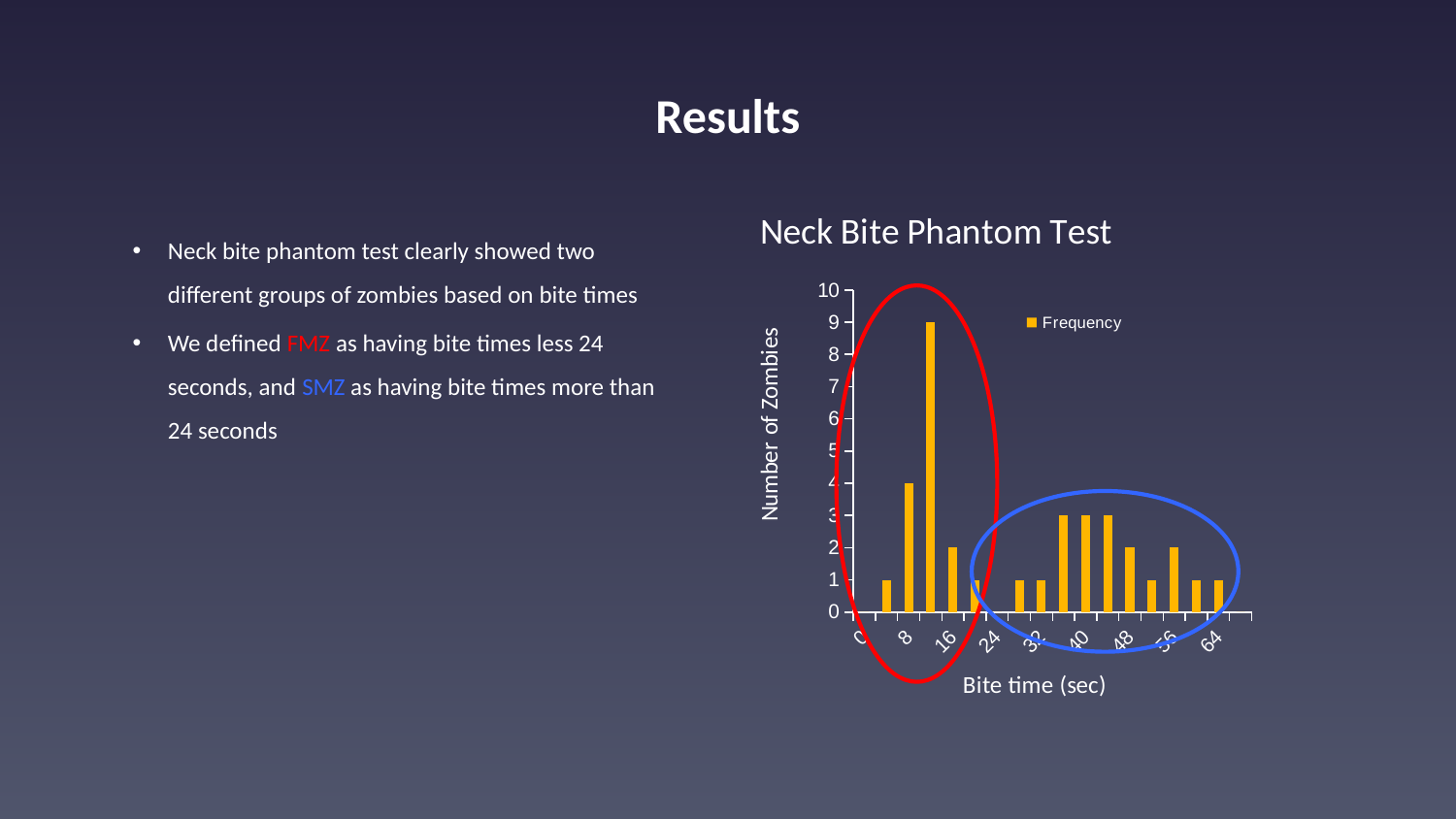
Is the tallest bar for bite times below 24 seconds taller or shorter than the tallest bar for bite times above 24 seconds? taller What is the smallest non-zero number of zombies shown by any bar? 1 What is the name of the series shown in the chart legend? Frequency What kind of chart is shown on the slide? bar chart How many series does the chart legend list? 1 What is the title of the chart? Neck Bite Phantom Test What is the maximum value shown on the Number of Zombies axis? 10 Is the tallest bar in the chart greater or less than 8 on the Number of Zombies axis? greater What is the highest number of zombies reached by any bar in the chart? 9 Are the bars for bite times above 24 seconds all less than 4 zombies? yes